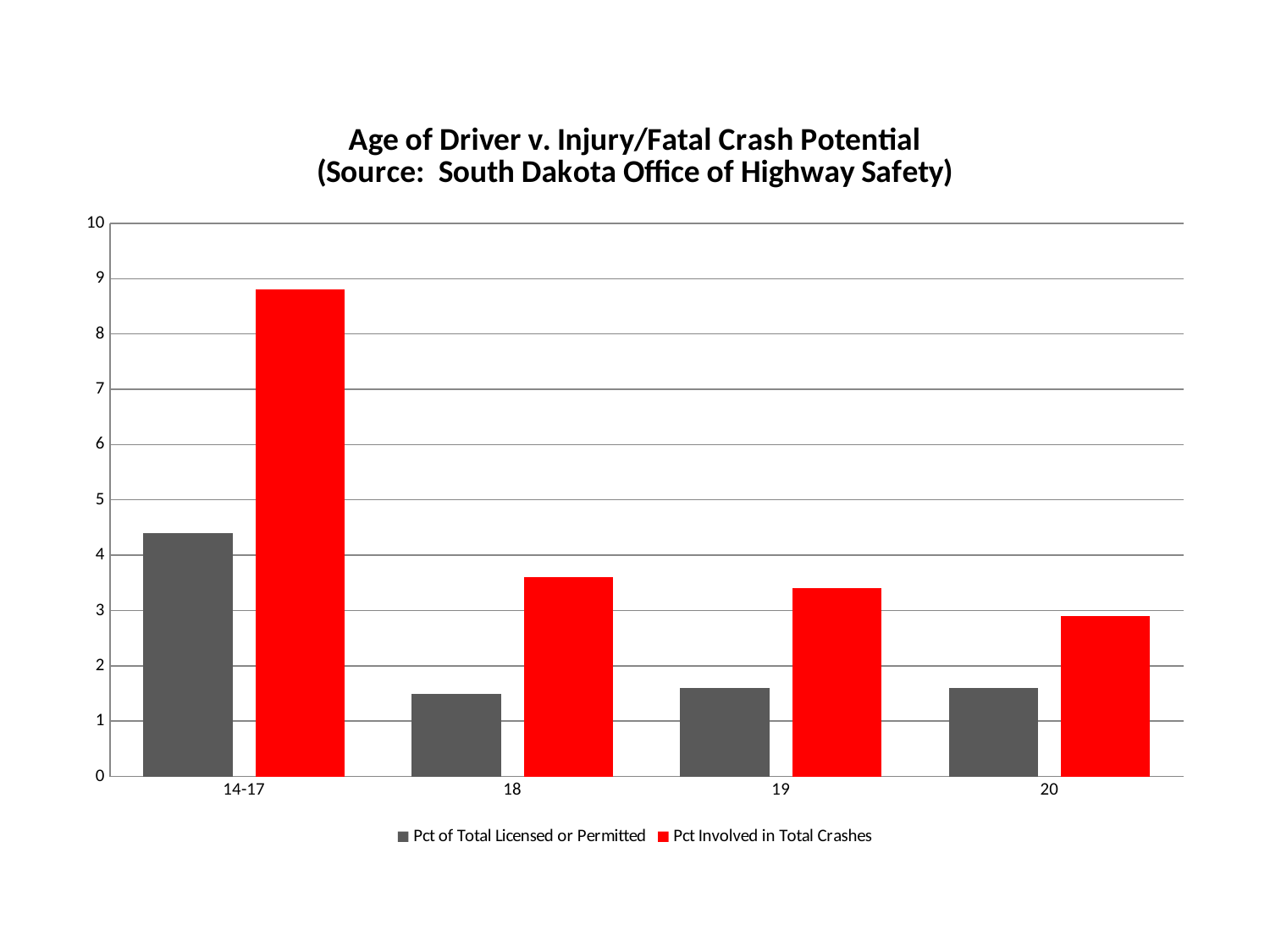
Which age group has the highest value for Pct Involved in Total Crashes? 14-17 Which is larger: Pct Involved in Total Crashes for age 18 or for age 20? age 18 How many age categories are shown on the x axis? 4 Which age group has the lowest value for Pct Involved in Total Crashes? 20 Which age group has the highest value for Pct of Total Licensed or Permitted? 14-17 Is the value for Pct of Total Licensed or Permitted for the 14-17 age group greater or less than 4? greater How many series does the legend list? 2 Is the value for Pct of Total Licensed or Permitted for the 18 age group greater or less than 2? less Do the values for Pct Involved in Total Crashes rise or fall moving from the 14-17 group to the 20 group? fall Is the value for Pct Involved in Total Crashes for the 14-17 age group greater or less than 8? greater What kind of chart is shown on the slide? bar chart